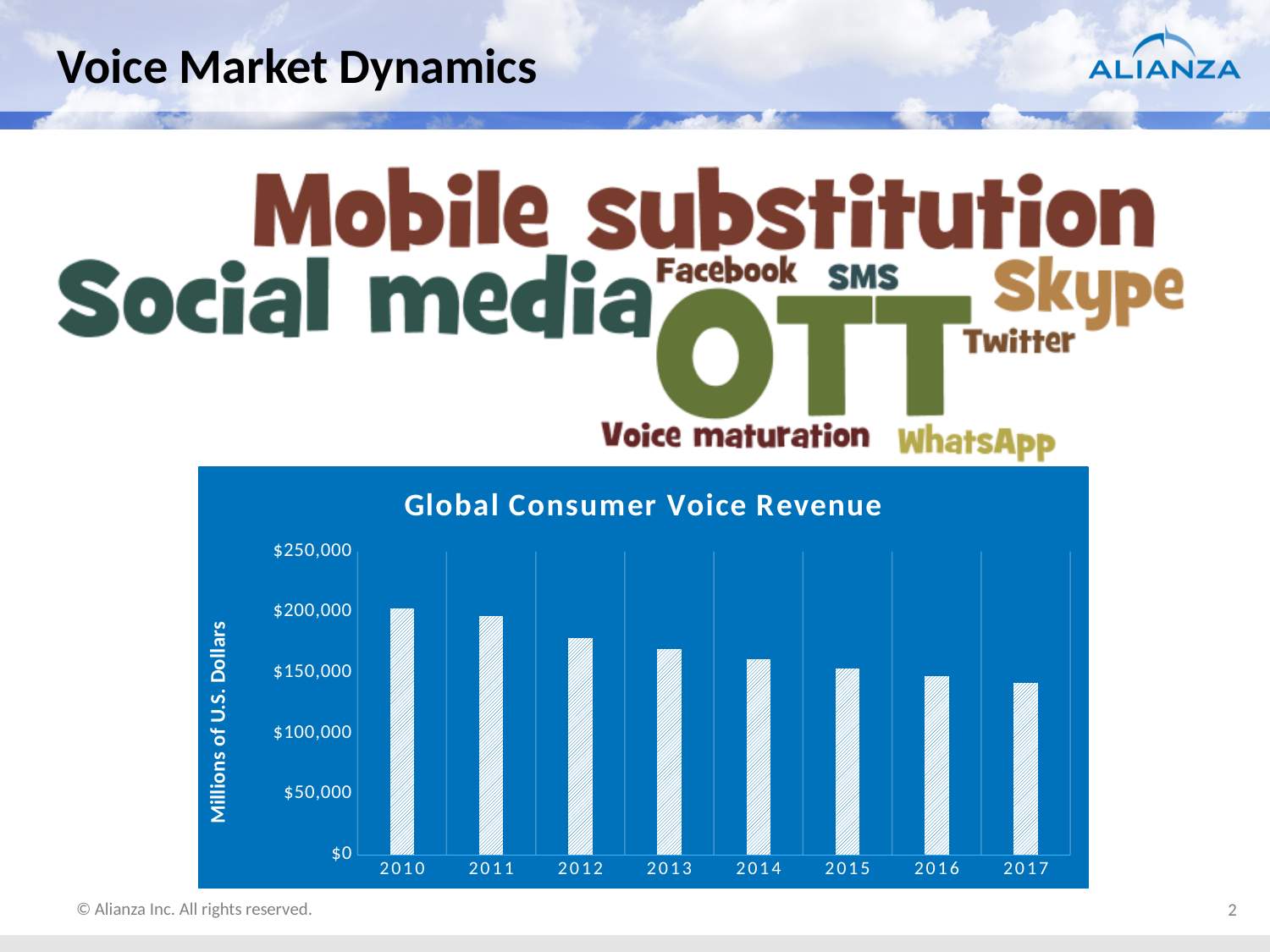
Which year has the larger value, 2012 or 2015? 2012 Which year has the highest global consumer voice revenue? 2010 Do the values rise or fall from 2010 to 2017? Fall Is the value for 2013 greater or less than $150,000? greater What is the title of the chart? Global Consumer Voice Revenue What type of chart is shown on the slide? Bar chart Is the value for 2010 greater or less than $150,000? greater Which year has the lowest global consumer voice revenue? 2017 Which year has the larger value, 2010 or 2017? 2010 How many years are shown on the x axis of the chart? 8 What is the label on the vertical axis of the chart? Millions of U.S. Dollars Is the value for 2017 greater or less than $150,000? less